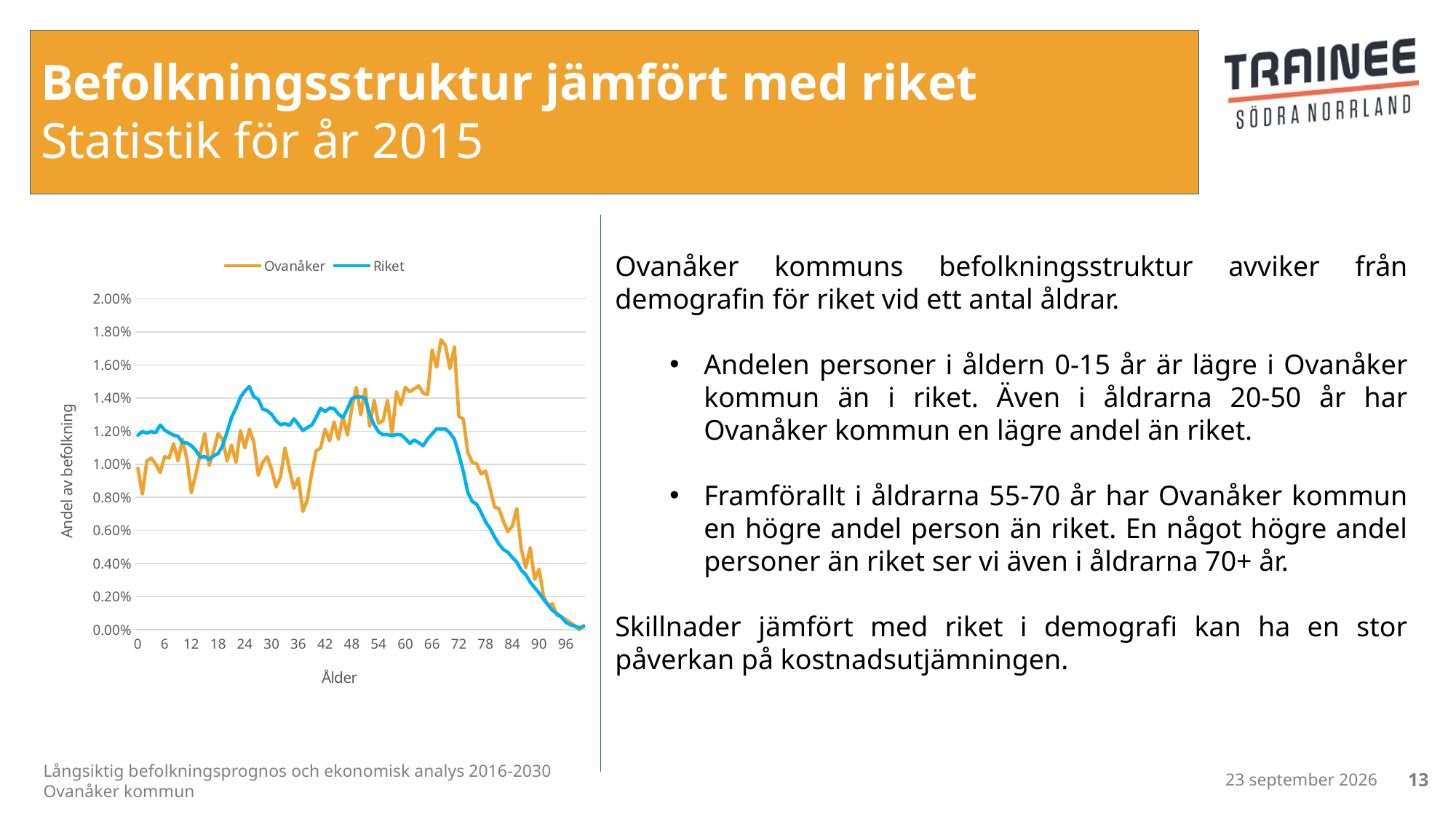
At age 68, which series has the higher value, Ovanåker or Riket? Ovanåker What kind of chart is shown on the slide? Line chart Do the values for Riket rise or fall from age 72 to age 96? Fall What are the two series named in the chart legend? Ovanåker and Riket Is the value for Riket at age 90 greater or less than 0.40%? less Which series reaches the highest value anywhere on the chart? Ovanåker At age 24, which series has the higher value, Ovanåker or Riket? Riket What is the label of the chart's x axis? Ålder Is the value for Riket at age 0 greater or less than 1.00%? greater Is the peak value of the Ovanåker line (around age 68) greater or less than 1.60%? greater How many series does the chart legend list? 2